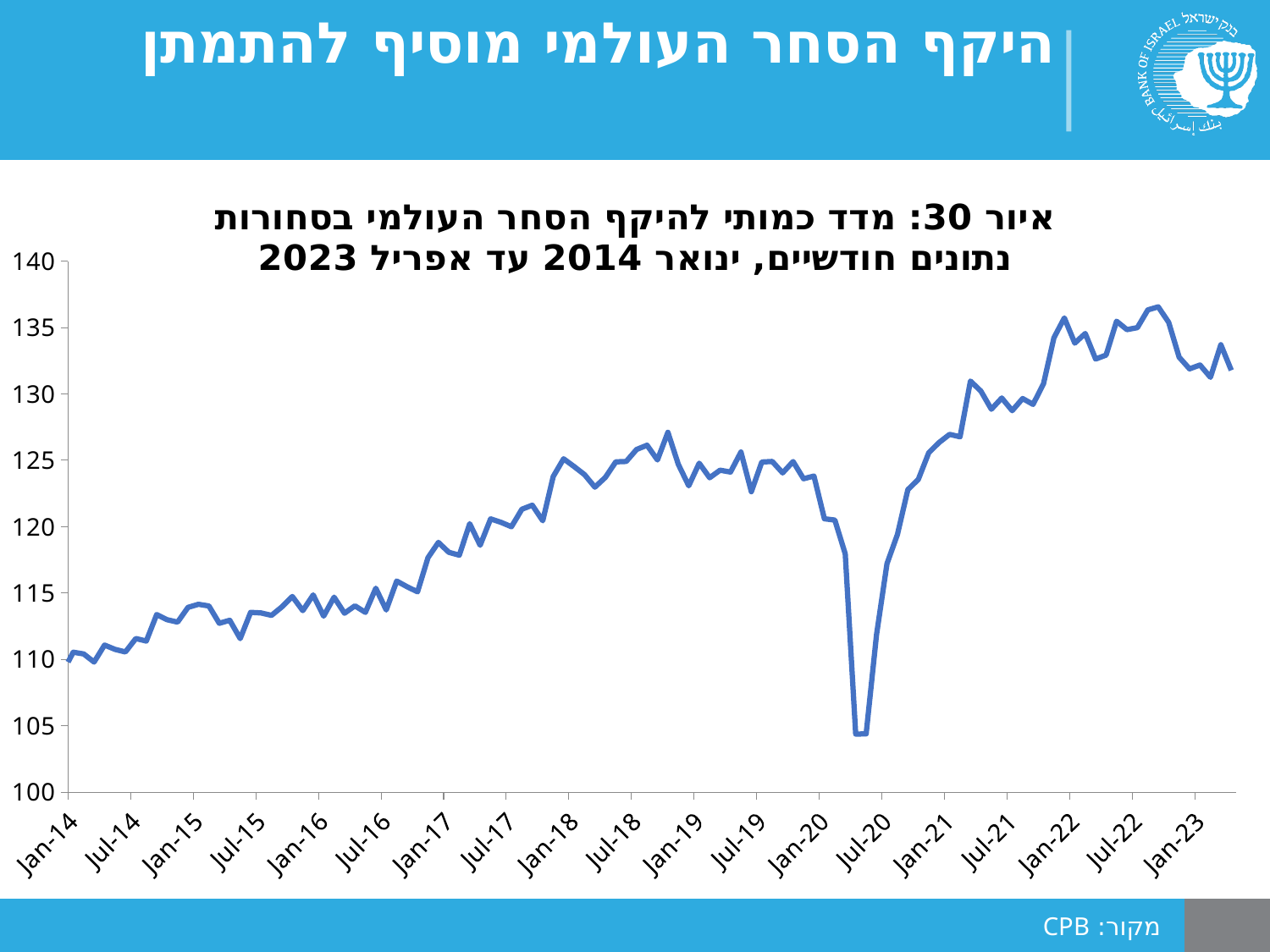
Around which x-axis label does the index reach its lowest point? Jul-20 Is the value of the index at Jan-18 greater or less than 120? greater Is the lowest point of the index, in the dip around Jul-20, greater or less than 110? less Is the value of the index at Jan-23 greater or less than 130? greater What kind of chart is shown on the slide? line chart What source is cited for the chart? CPB What is the highest value shown on the y axis? 140 Around which x-axis label does the index reach its highest point? Jul-22 Which is larger: the index value at Jan-14 or at Jan-23? Jan-23 Overall, does the index rise or fall from Jan-14 to Jan-23? rise